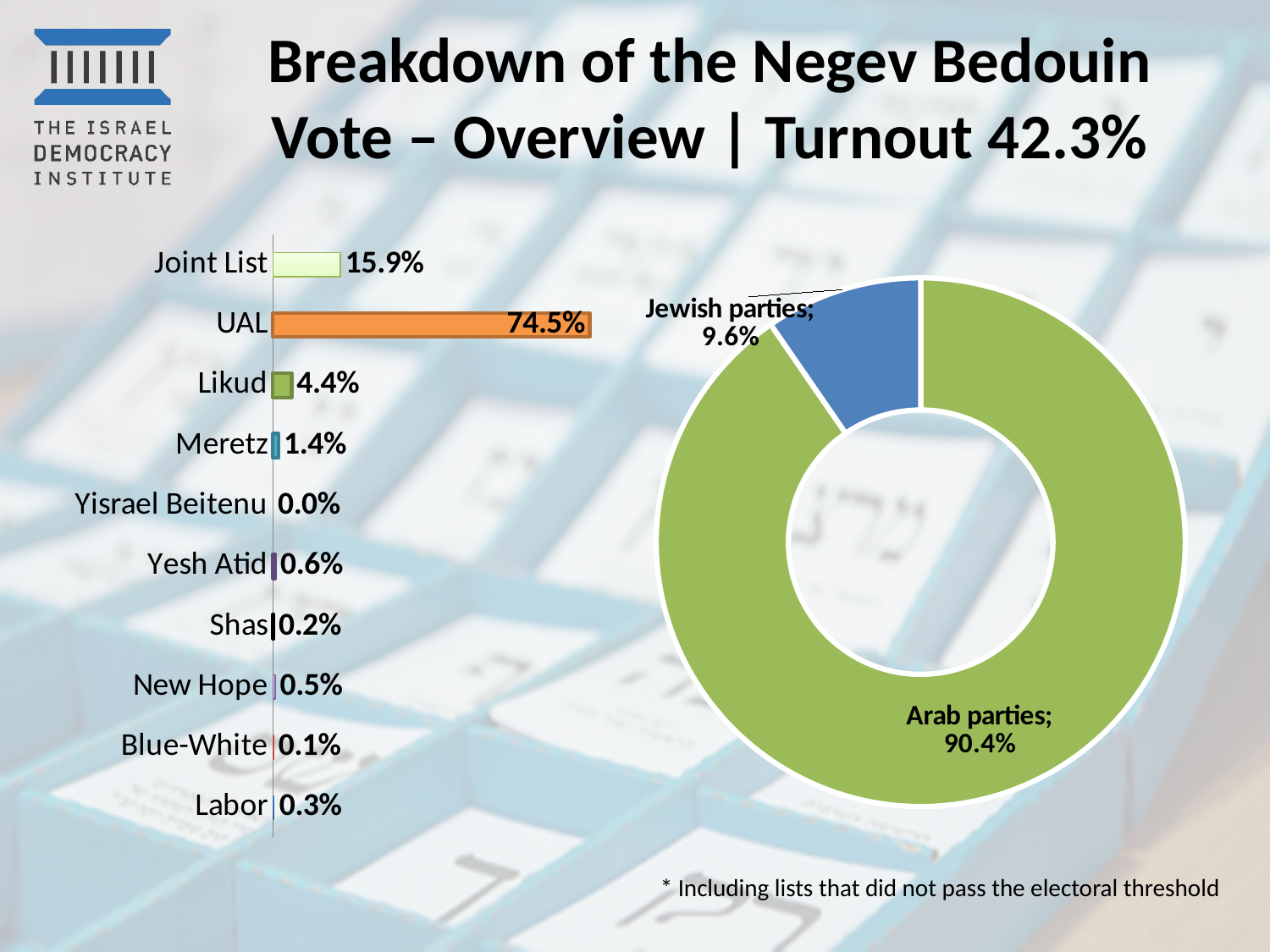
In the bar chart on the left, what is the value for UAL? 74.5% In the bar chart on the left, what is the value for Joint List? 15.9% In the donut chart on the right, what share do Jewish parties have? 9.6% What kind of chart is on the right side of the slide? Donut chart In the bar chart on the left, what is the value for Likud? 4.4% In the donut chart on the right, what share do Arab parties have? 90.4% How many parties are listed in the bar chart on the left? 10 In the bar chart on the left, which is larger, the value for Likud or the value for Meretz? Likud What kind of chart is on the left side of the slide? Bar chart In the bar chart on the left, what is the difference between the values for UAL and Joint List? 58.6% In the bar chart on the left, which party has the highest value? UAL In the bar chart on the left, which party has the lowest value? Yisrael Beitenu